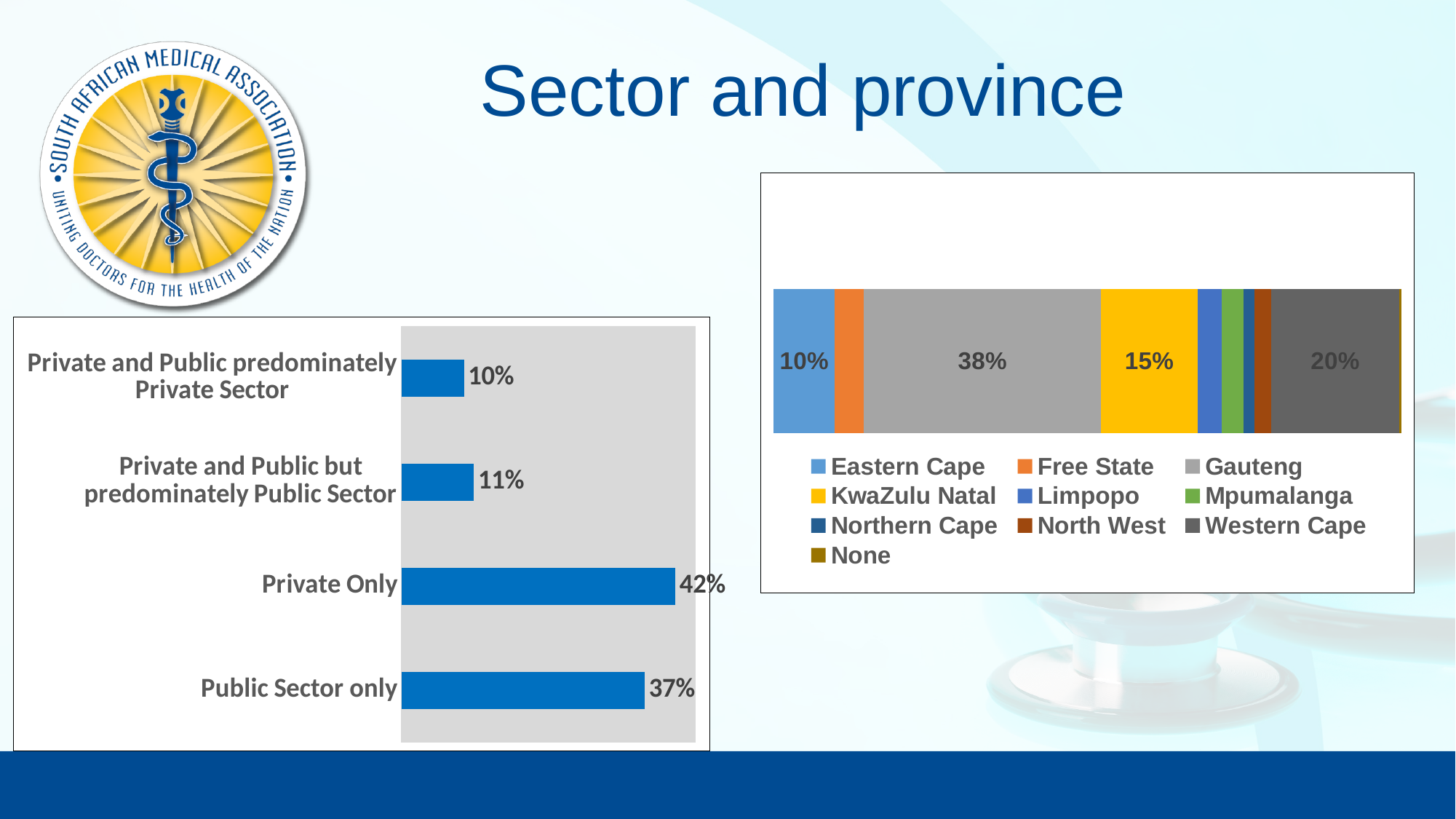
In the bar chart on the left of the slide, how many categories are shown? 4 In the stacked bar chart on the right of the slide, what is the value for Western Cape? 20% In the stacked bar chart on the right of the slide, which is larger, KwaZulu Natal or Eastern Cape? KwaZulu Natal In the stacked bar chart on the right of the slide, what is the value for Gauteng? 38% In the bar chart on the left of the slide, what is the value for Private Only? 42% In the bar chart on the left of the slide, what is the value for Public Sector only? 37% In the bar chart on the left of the slide, which category has the lowest value? Private and Public predominately Private Sector In the bar chart on the left of the slide, which category has the highest value? Private Only In the bar chart on the left of the slide, what is the value for Private and Public but predominately Public Sector? 11% How many entries does the legend of the stacked bar chart on the right of the slide list? 10 In the bar chart on the left of the slide, what is the difference between Private Only and Public Sector only? 5% What kind of chart is on the left of the slide? Bar chart